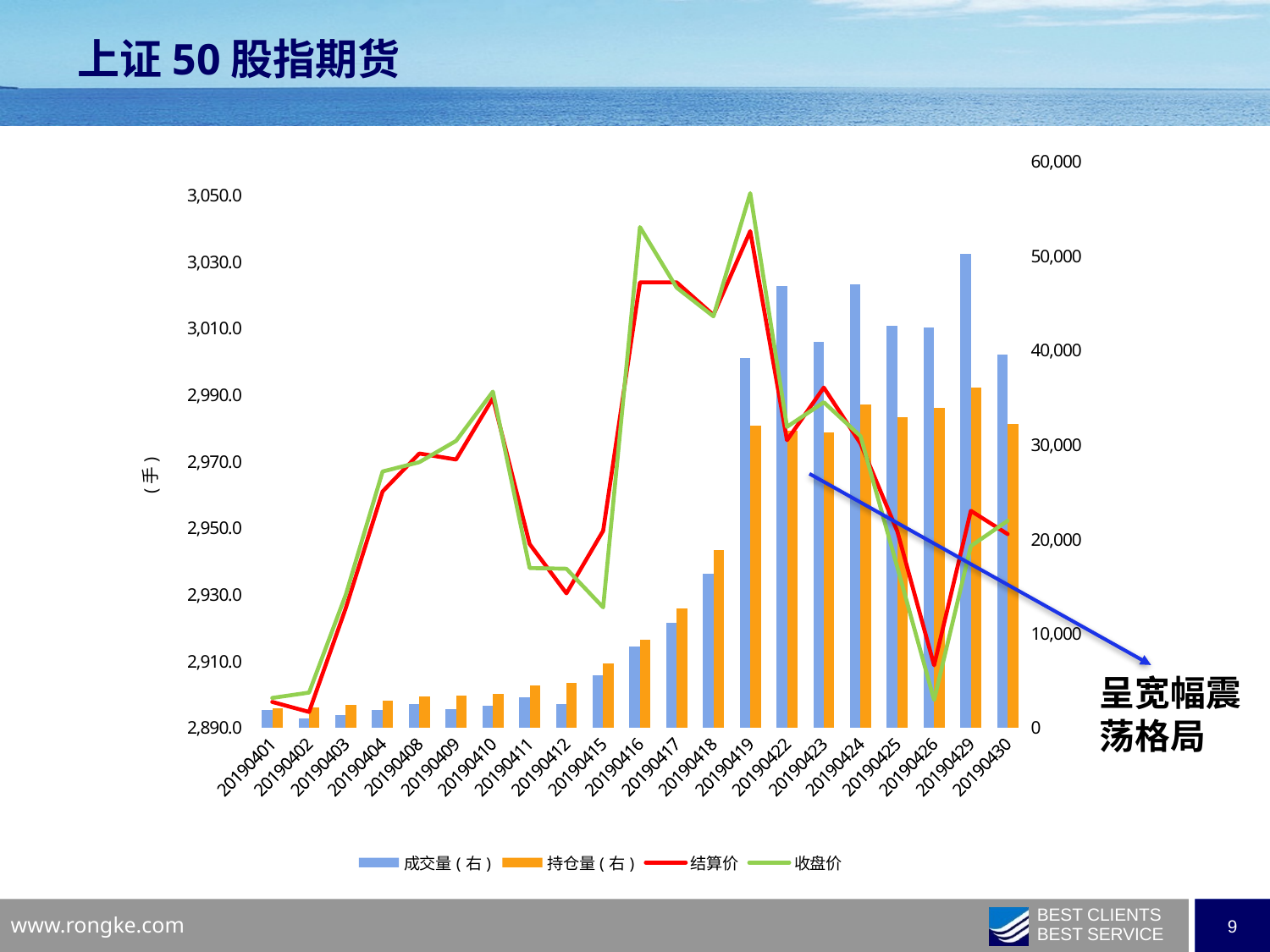
Does the 成交量 series rise or fall from 20190401 to 20190419? rise What kind of chart is shown on the slide? A combined bar and line chart Which date has the larger 成交量 bar, 20190422 or 20190423? 20190422 On which date does the 收盘价 line reach its highest point? 20190419 On which date is the 成交量 bar lowest? 20190402 How many dates are shown on the x axis? 21 Is the 成交量 value for 20190429 greater or less than 40,000? greater How many series does the legend list? 4 On which date is the 成交量 bar highest? 20190429 Is the 收盘价 value for 20190426 greater or less than 2,910.0? less What is the title of the chart on the slide? 上证 50 股指期货 On which date does the 收盘价 line reach its lowest point? 20190426